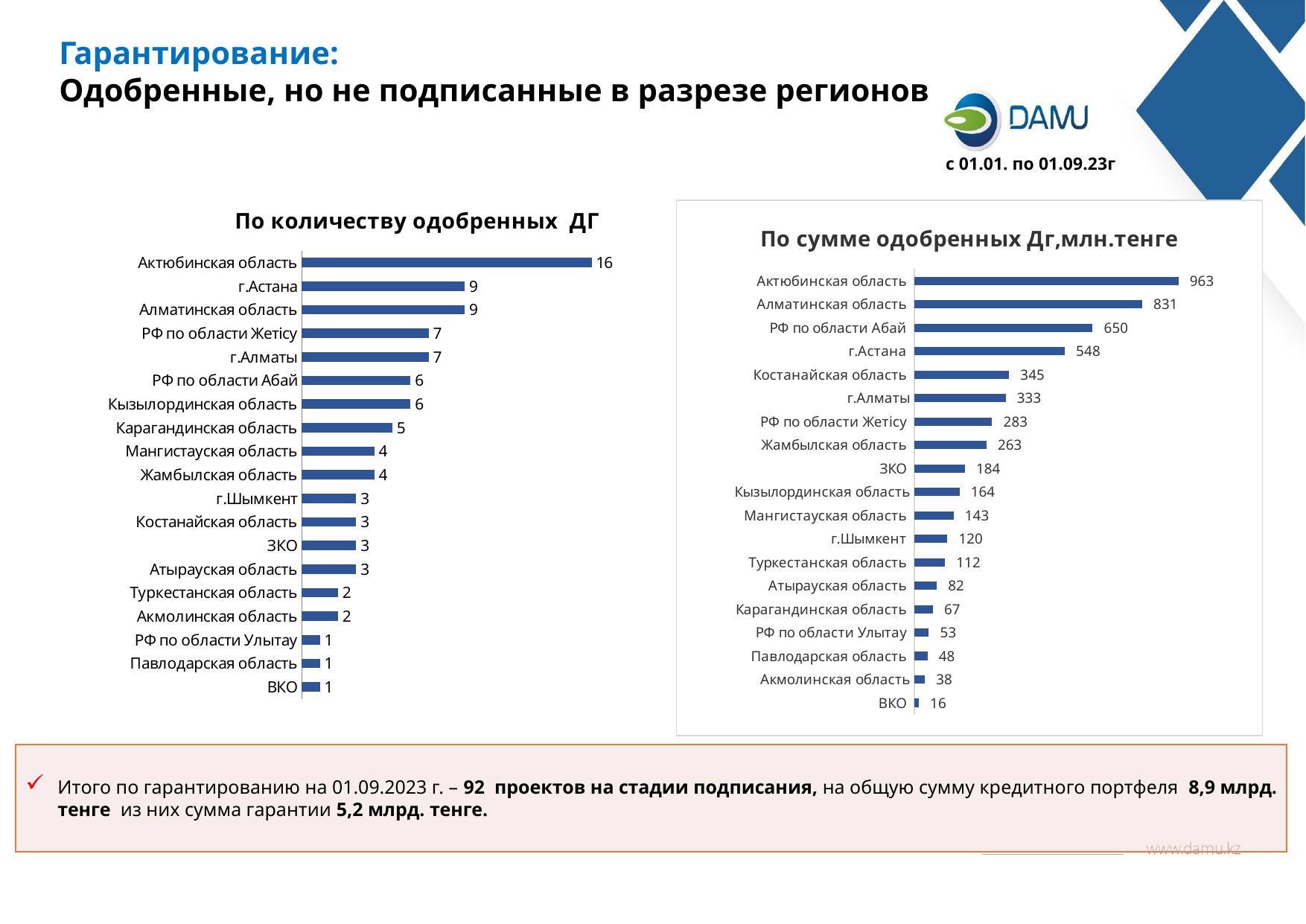
How many regions are shown in the chart 'По сумме одобренных Дг,млн.тенге'? 19 In the chart 'По сумме одобренных Дг,млн.тенге', which region has the highest value? Актюбинская область In the chart 'По сумме одобренных Дг,млн.тенге', what is the value for ВКО? 16 What is the title of the chart on the right side of the slide? По сумме одобренных Дг,млн.тенге In the chart 'По сумме одобренных Дг,млн.тенге', what is the value for г.Астана? 548 In the chart 'По сумме одобренных Дг,млн.тенге', which is larger: Костанайская область or г.Алматы? Костанайская область In the chart 'По количеству одобренных ДГ', what is the value for Актюбинская область? 16 In the chart 'По сумме одобренных Дг,млн.тенге', what is the difference between Актюбинская область and Алматинская область? 132 What kind of chart is 'По количеству одобренных ДГ'? Bar chart In the chart 'По количеству одобренных ДГ', which is larger: Карагандинская область or Мангистауская область? Карагандинская область In the chart 'По количеству одобренных ДГ', what is the difference between Актюбинская область and г.Астана? 7 In the chart 'По количеству одобренных ДГ', which region has the lowest value among those listed at the bottom, ВКО, with what value? 1